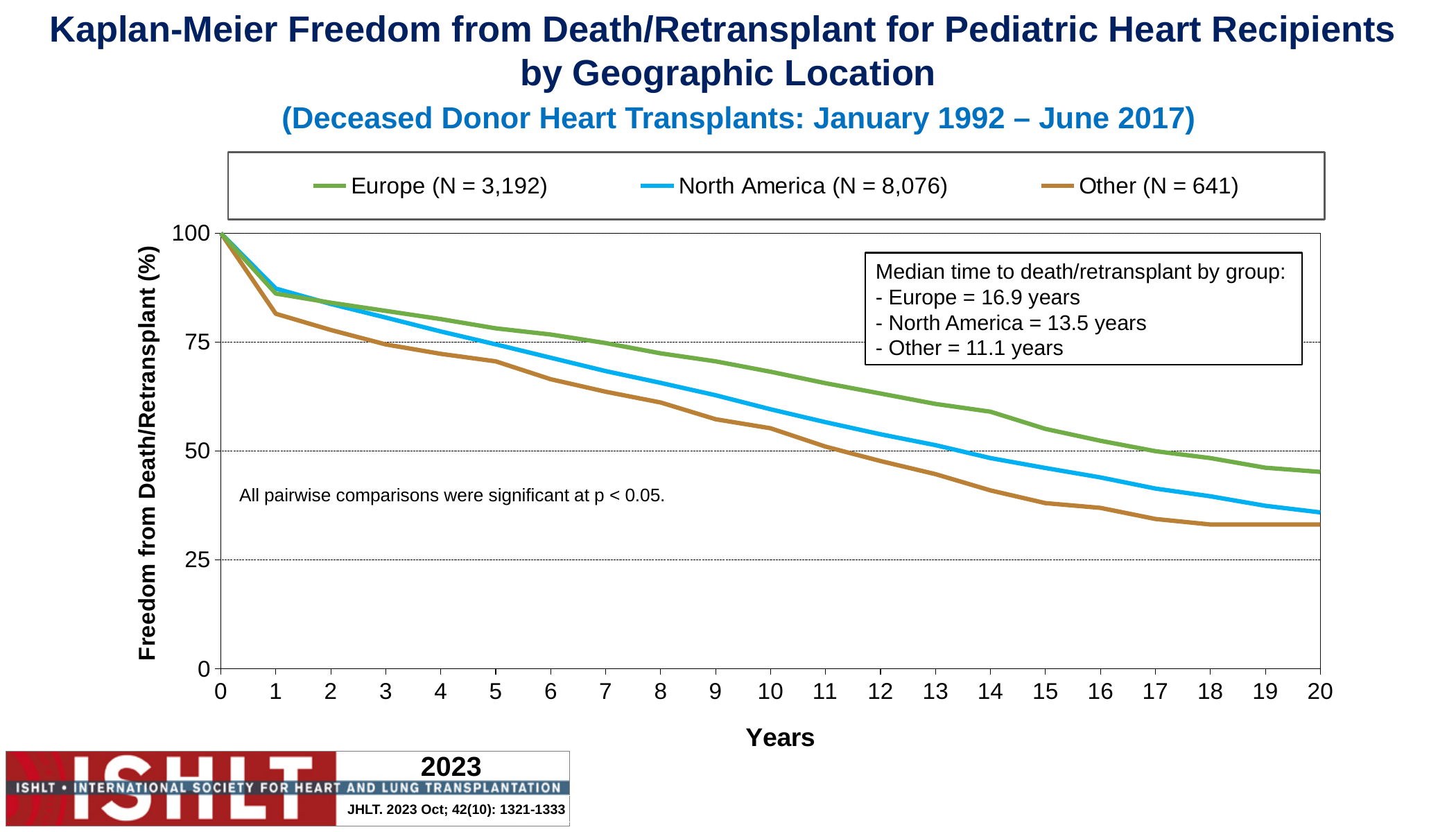
What is the difference in median time to death/retransplant between Europe and Other? 5.8 years According to the text box, what is the median time to death/retransplant for North America? 13.5 years What kind of chart is shown on the slide? line chart How many series does the legend list? 3 Do the curves rise or fall as the number of years increases? fall At 20 years, is the freedom from death/retransplant for Other greater or less than 50? less According to the text box, what is the median time to death/retransplant for Europe? 16.9 years Which group has the shortest median time to death/retransplant? Other What is the N for the North America series in the legend? 8,076 According to the text box, what is the median time to death/retransplant for Other? 11.1 years Which group has the longest median time to death/retransplant? Europe At 10 years, is the freedom from death/retransplant for Europe greater or less than 50? greater